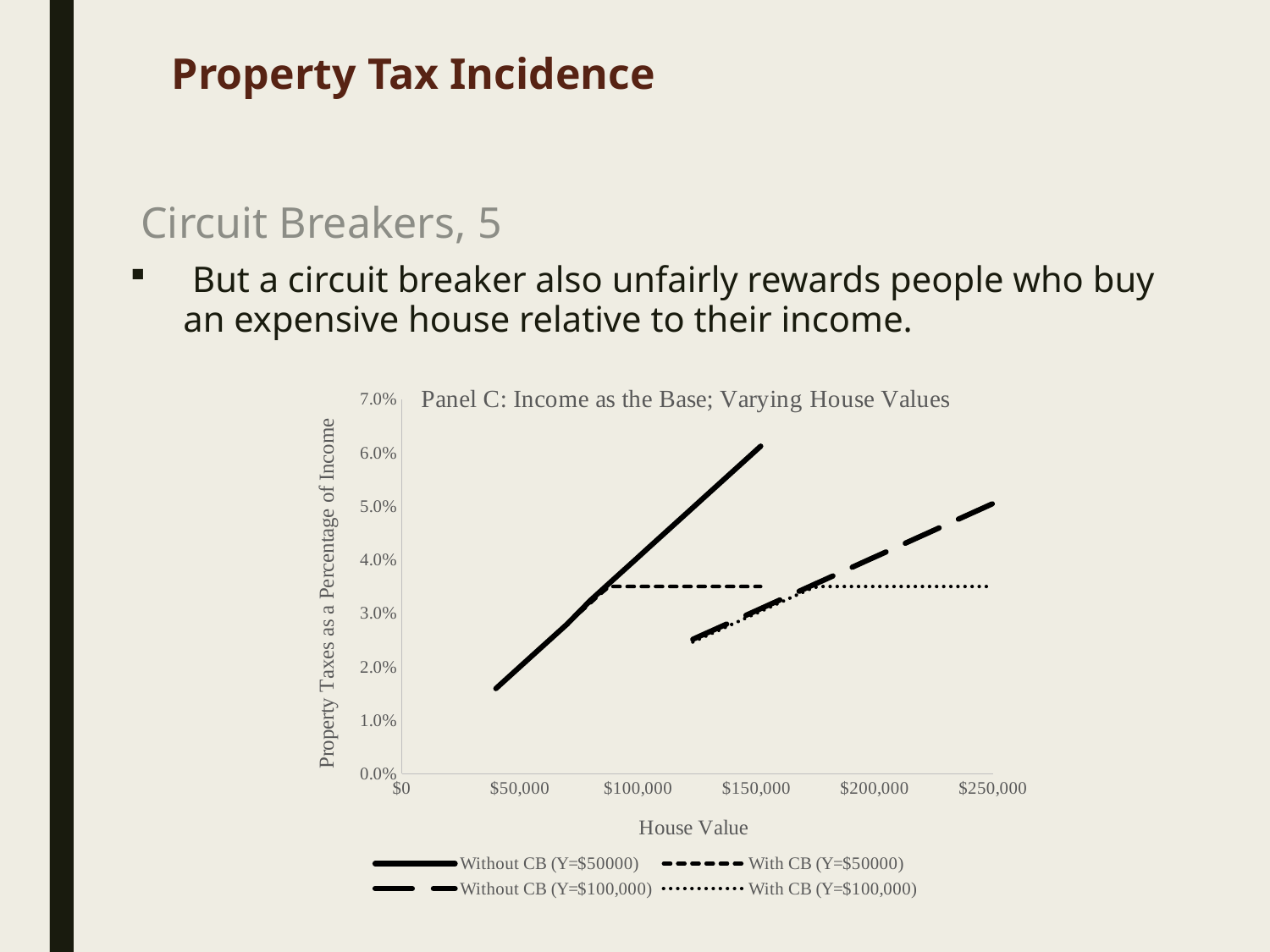
Is the value of the Without CB (Y=$50000) line at a house value of $150,000 greater or less than 5.0%? greater At a house value of $150,000, which line is higher: Without CB (Y=$50000) or With CB (Y=$50000)? Without CB (Y=$50000) Is the value of the With CB (Y=$50000) line at a house value of $150,000 greater or less than 4.0%? less Which series reaches the highest value anywhere on the chart? Without CB (Y=$50000) What is the title of the chart? Panel C: Income as the Base; Varying House Values At a house value of $250,000, which line is higher: Without CB (Y=$100,000) or With CB (Y=$100,000)? Without CB (Y=$100,000) How many series does the chart legend list? 4 Is the value of the Without CB (Y=$100,000) line at a house value of $250,000 greater or less than 4.0%? greater Does the Without CB (Y=$50000) line rise or fall as house value increases? rise What kind of chart is shown on the slide? Line chart What is the label of the chart's vertical axis? Property Taxes as a Percentage of Income